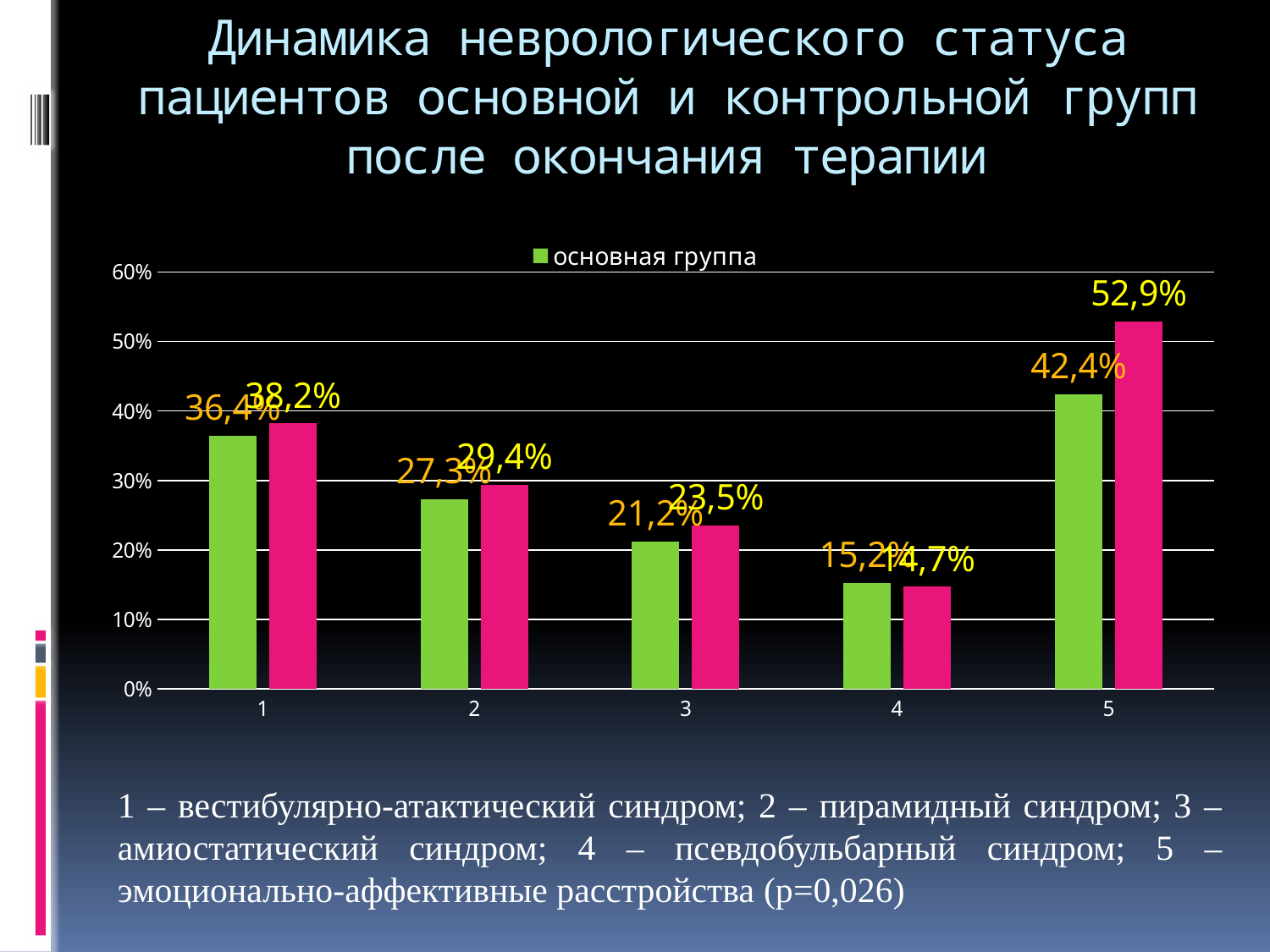
Is the value of the pink bar for category 5 greater or less than 50%? greater What type of chart is shown on the slide? bar chart What is the value of the green bar (основная группа) for category 5? 42,4% What is the difference between the pink bar and the green bar for category 5? 10,5% How many categories are shown on the x axis of the chart? 5 What series name is shown in the chart legend? основная группа What is the value of the green bar (основная группа) for category 1? 36,4% For category 2, which bar is larger, the green one or the pink one? pink What is the value of the pink bar for category 5? 52,9% What is the value of the pink bar for category 3? 23,5% Which category has the lowest value for the green series (основная группа)? 4 Which category has the highest value for the pink series? 5